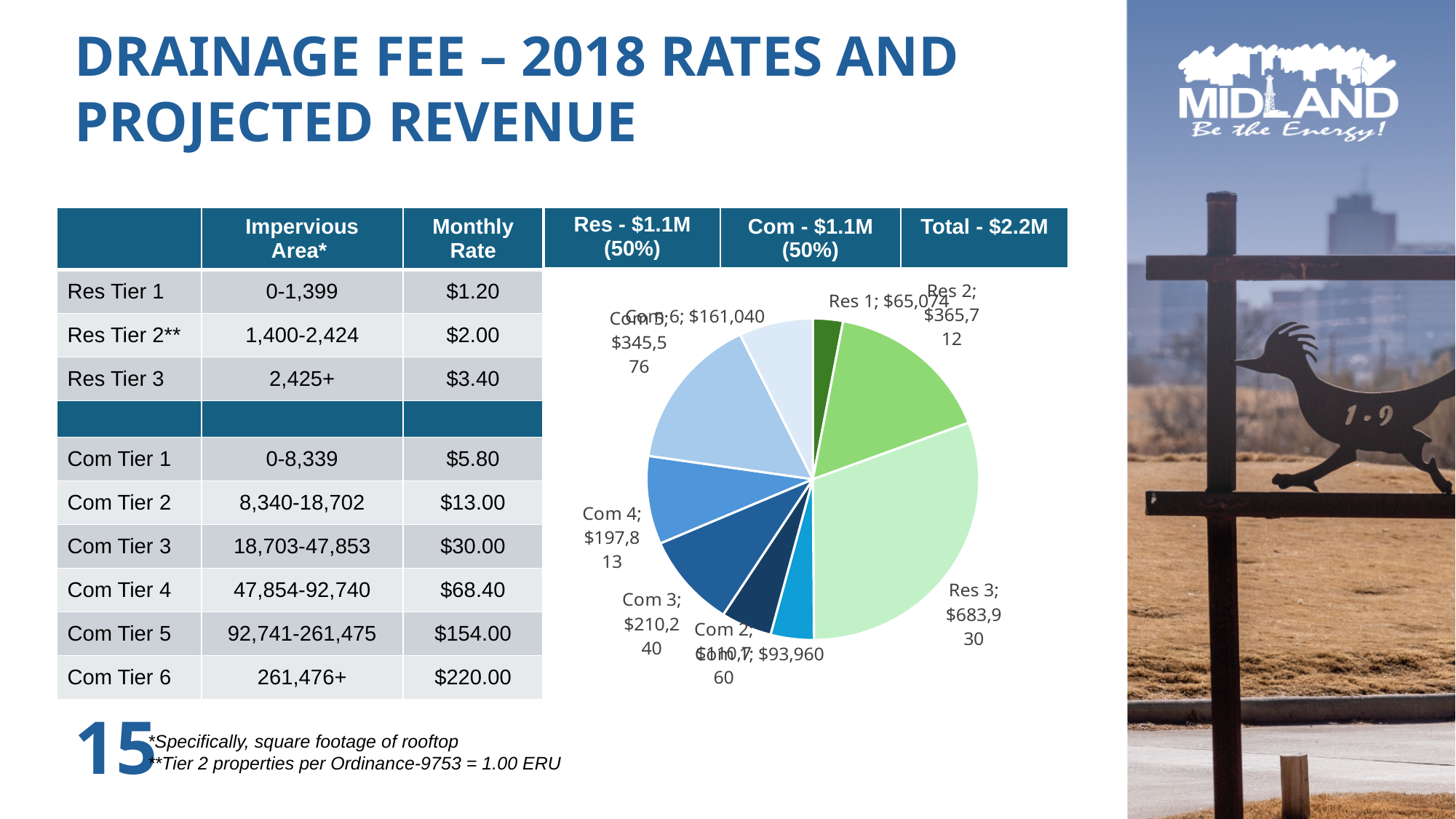
Which category has the smallest slice in the pie chart? Res 1 How many slices does the pie chart have? 9 What is the value shown for Com 4 in the pie chart? $197,813 What is the combined value of the three residential slices (Res 1, Res 2 and Res 3) in the pie chart? $1,114,716 What is the value shown for Com 6 in the pie chart? $161,040 Which category has the largest slice in the pie chart? Res 3 What is the value shown for Com 1 in the pie chart? $93,960 What is the difference between the Res 3 and Res 2 values in the pie chart? $318,218 Which is larger in the pie chart, Com 5 or Com 6? Com 5 What is the value shown for Res 3 in the pie chart? $683,930 What is the value shown for Res 2 in the pie chart? $365,712 What kind of chart is shown on the slide? pie chart